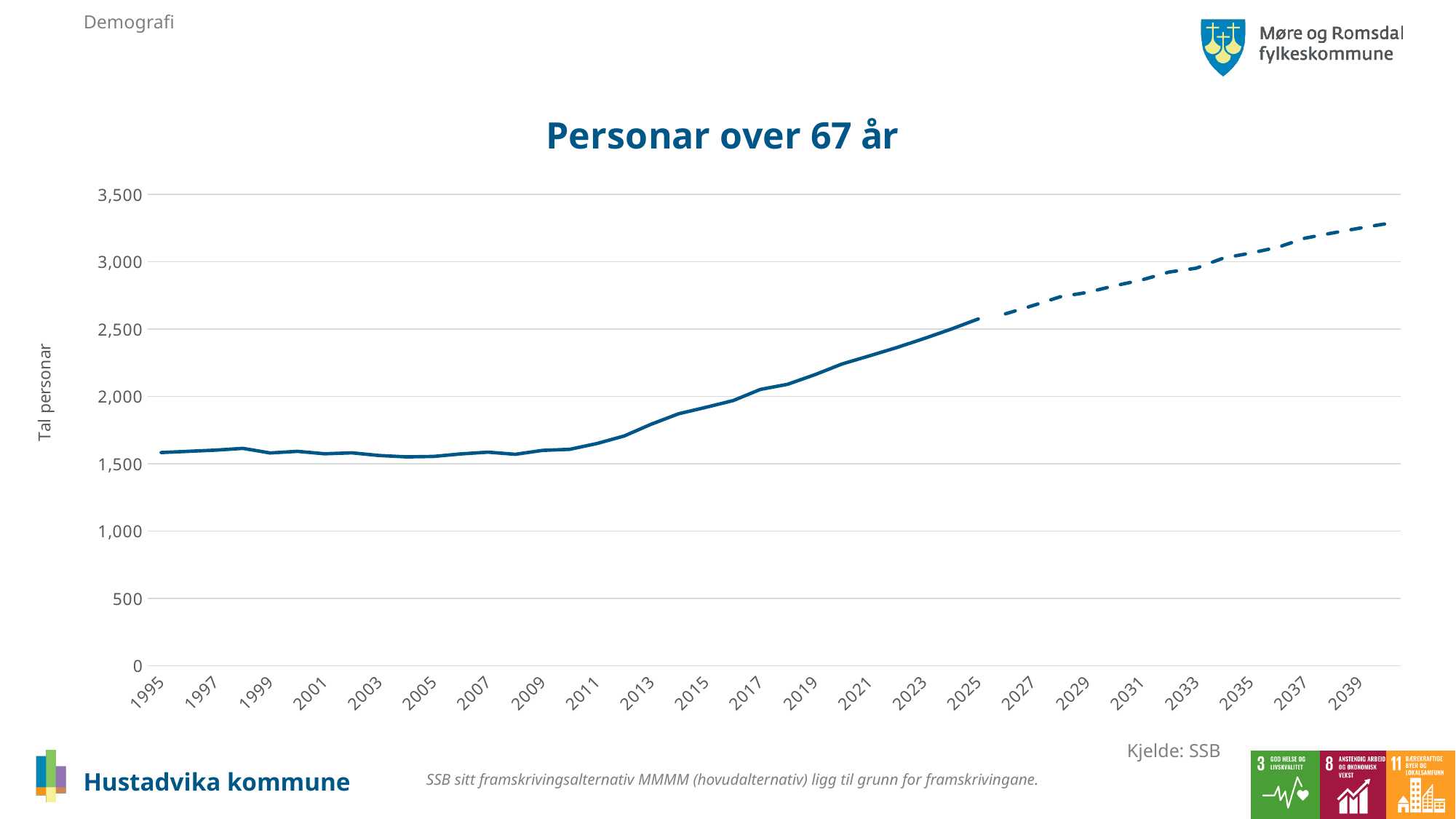
Is the value for 1995 greater or less than 2,000? less Is the value for 2039 greater or less than 3,000? greater What is the title of the chart? Personar over 67 år Is the value for 2039 greater or less than 3,500? less What is the label on the vertical axis of the chart? Tal personar Do the values in the chart generally rise or fall from 2011 to 2039? rise Which year has the larger value, 2005 or 2025? 2025 What kind of chart is shown on the slide? line chart